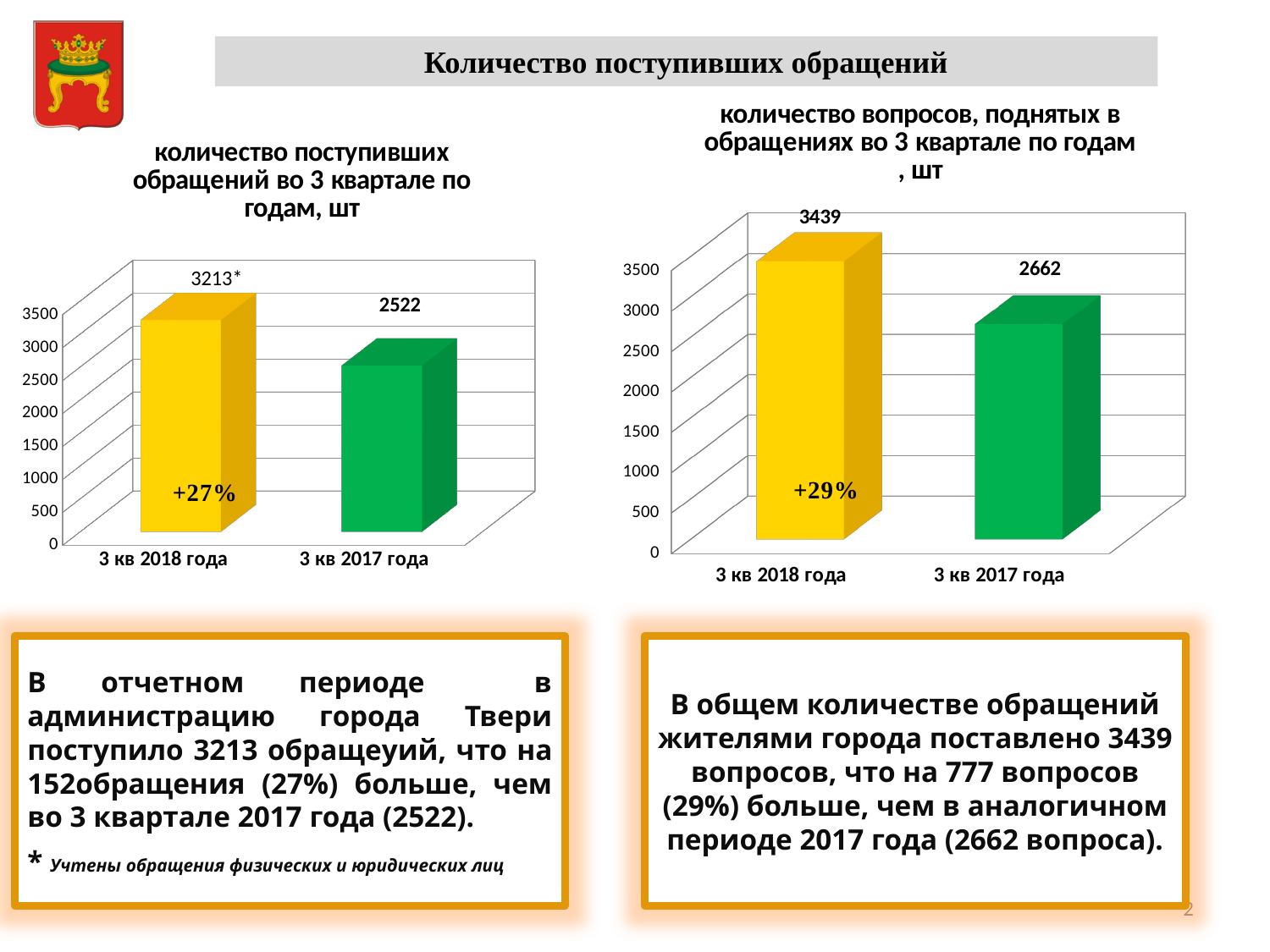
On the right chart (количество вопросов, поднятых в обращениях во 3 квартале по годам, шт), what is the value for 3 кв 2018 года? 3439 On the left chart (количество поступивших обращений во 3 квартале по годам, шт), what is the value for 3 кв 2017 года? 2522 How many categories are shown on the left chart? 2 On the left chart (количество поступивших обращений во 3 квартале по годам, шт), what is the value for 3 кв 2018 года? 3213 On the right chart, which category has the lowest value? 3 кв 2017 года What kind of chart is the right chart? bar chart On the left chart, what is the difference between the values for 3 кв 2018 года and 3 кв 2017 года? 691 On the right chart, which is larger: the value for 3 кв 2018 года or for 3 кв 2017 года? 3 кв 2018 года On the right chart, what is the difference between the values for 3 кв 2018 года and 3 кв 2017 года? 777 On the right chart (количество вопросов, поднятых в обращениях во 3 квартале по годам, шт), what is the value for 3 кв 2017 года? 2662 On the left chart, which category has the highest value? 3 кв 2018 года On the left chart, what percentage change label is printed on the bar for 3 кв 2018 года? +27%